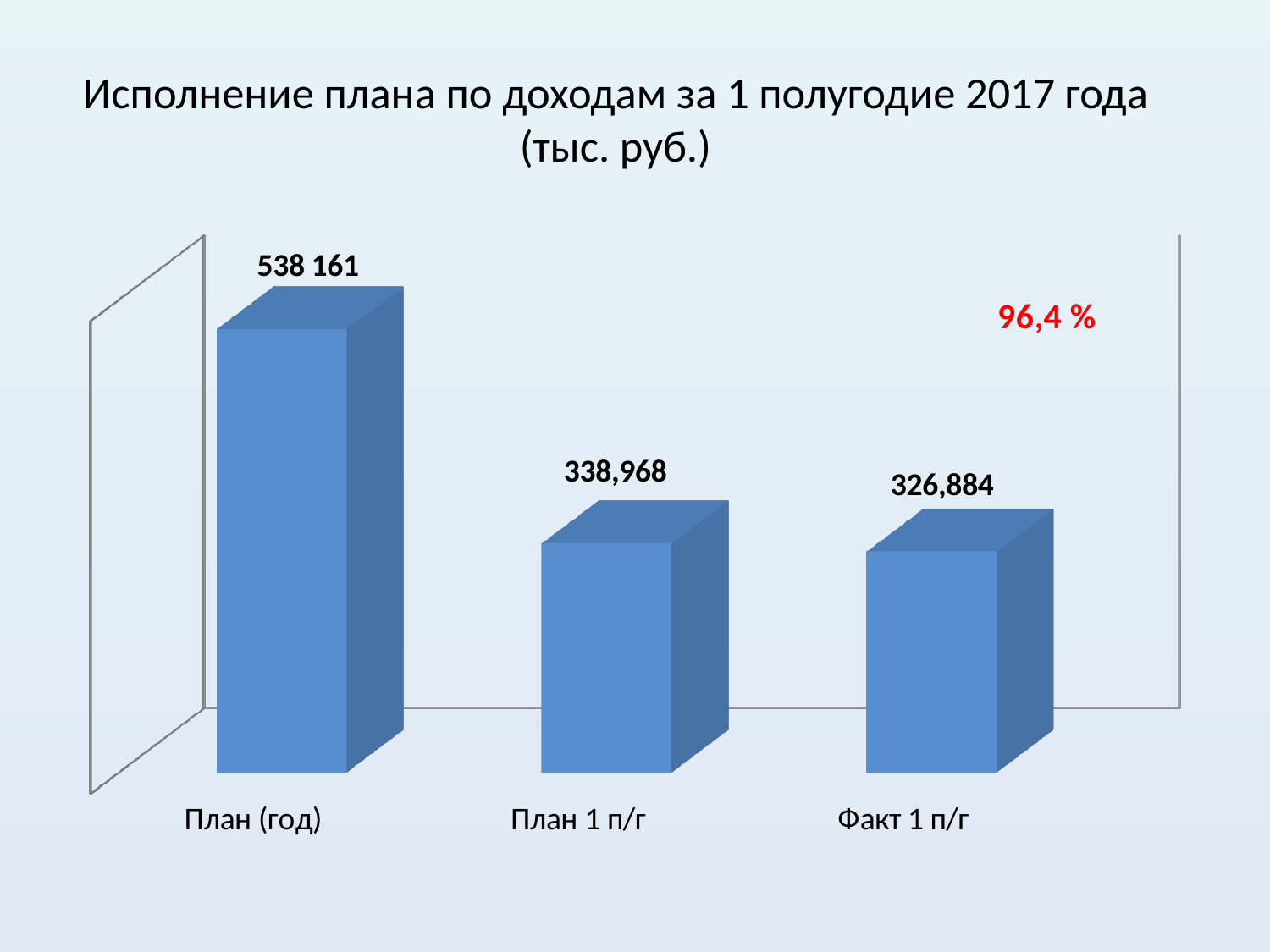
What unit is given in the chart title? тыс. руб. What is the value for План 1 п/г? 338,968 What is the value for Факт 1 п/г? 326,884 Which is larger, План 1 п/г or Факт 1 п/г? План 1 п/г Which category has the lowest value? Факт 1 п/г How many categories are shown in the chart? 3 Which category has the highest value? План (год) What is the difference between План 1 п/г and Факт 1 п/г? 12,084 What percentage is shown in red on the chart? 96,4 % What kind of chart is shown on the slide? Bar chart Do the values rise or fall from left to right across the categories? Fall What is the value for План (год)? 538 161